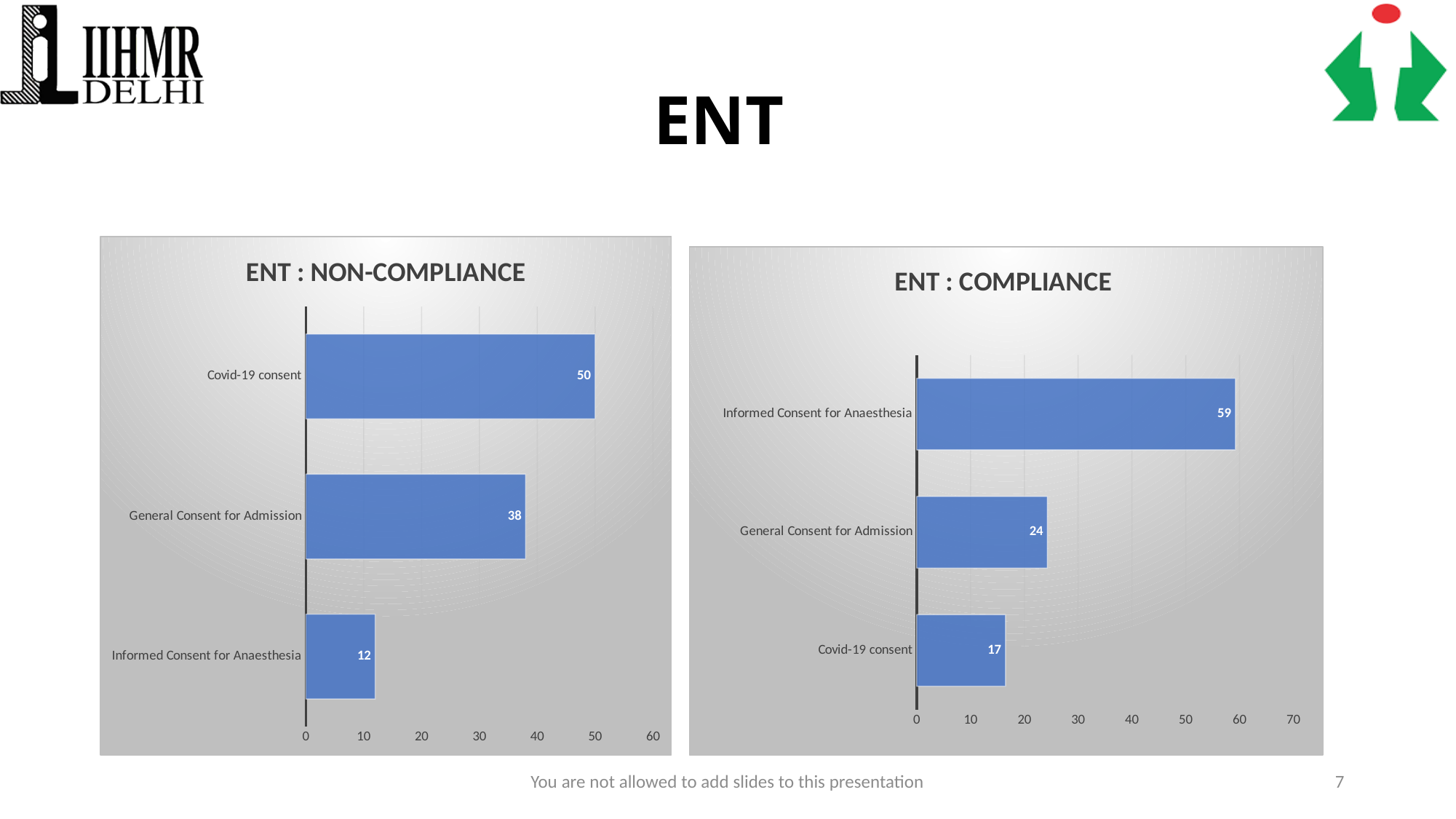
How many categories are shown in the ENT : NON-COMPLIANCE chart? 3 In the ENT : COMPLIANCE chart, what is the value for Informed Consent for Anaesthesia? 59 In the ENT : COMPLIANCE chart, which category has the highest value? Informed Consent for Anaesthesia In the ENT : COMPLIANCE chart, what is the difference between the values for Informed Consent for Anaesthesia and General Consent for Admission? 35 In the ENT : NON-COMPLIANCE chart, which category has the lowest value? Informed Consent for Anaesthesia In the ENT : NON-COMPLIANCE chart, what is the value for General Consent for Admission? 38 In the ENT : COMPLIANCE chart, which is larger: General Consent for Admission or Covid-19 consent? General Consent for Admission In the ENT : NON-COMPLIANCE chart, what is the value for Covid-19 consent? 50 In the ENT : NON-COMPLIANCE chart, what is the difference between the values for Covid-19 consent and Informed Consent for Anaesthesia? 38 What kind of chart is the ENT : COMPLIANCE chart? Bar chart What is the title of the chart on the left side of the slide? ENT : NON-COMPLIANCE In the ENT : COMPLIANCE chart, what is the value for Covid-19 consent? 17